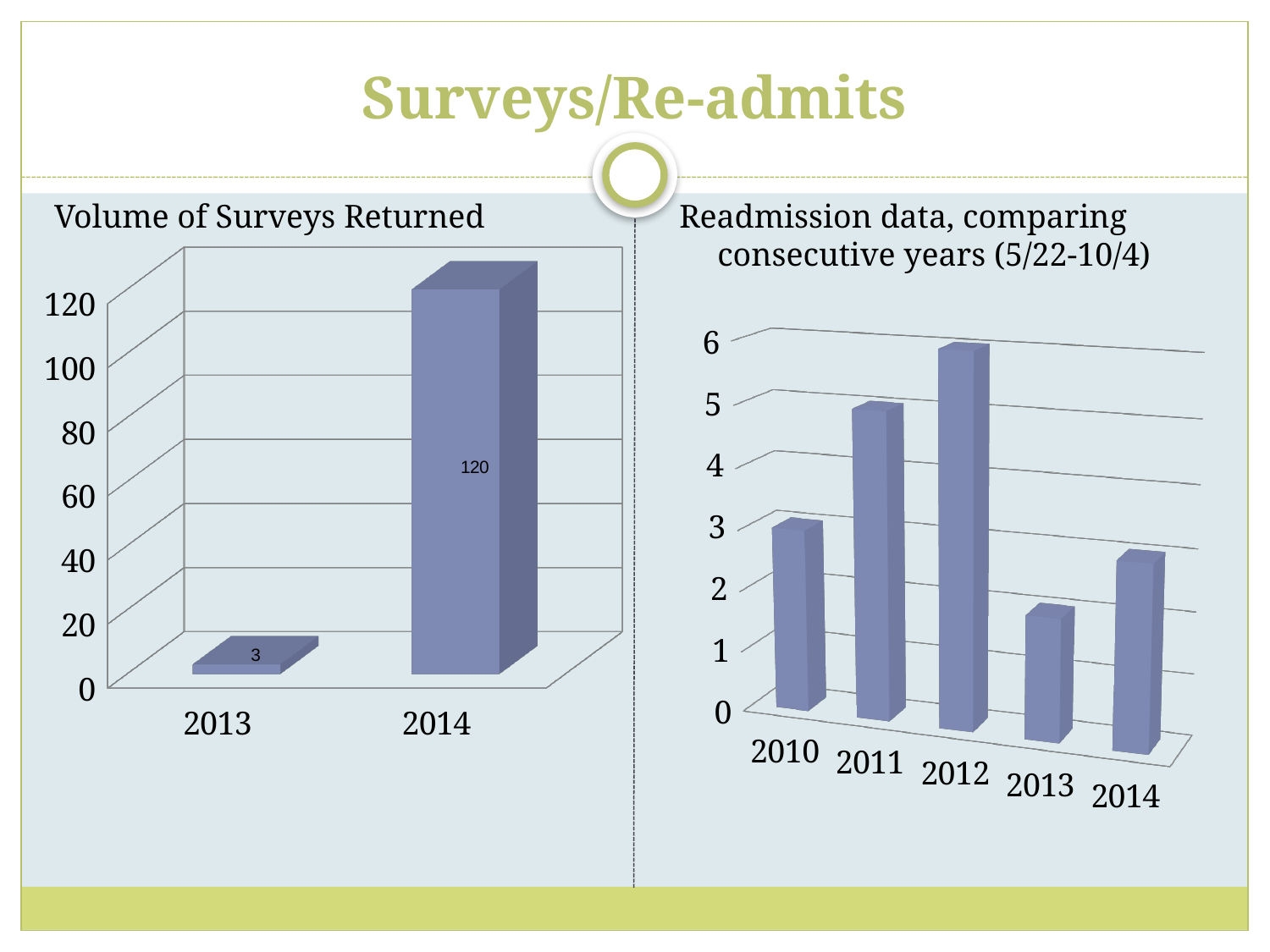
On the Readmission data chart, is the value for 2012 greater or less than 4? greater On the Readmission data chart, how many years are shown on the x axis? 5 On the Readmission data chart, which year has the lowest value? 2013 On the Volume of Surveys Returned chart, what is the value for 2013? 3 On the Volume of Surveys Returned chart, what is the difference between the 2014 and 2013 values? 117 On the Volume of Surveys Returned chart, what is the value for 2014? 120 On the Readmission data chart, which is larger, the value for 2011 or the value for 2010? 2011 On the Volume of Surveys Returned chart, how many categories are shown on the x axis? 2 On the Readmission data chart, which year has the highest value? 2012 What kind of chart is the Volume of Surveys Returned chart? Bar chart On the Volume of Surveys Returned chart, which year has the higher value? 2014 On the Readmission data chart, is the value for 2013 greater or less than 3? less